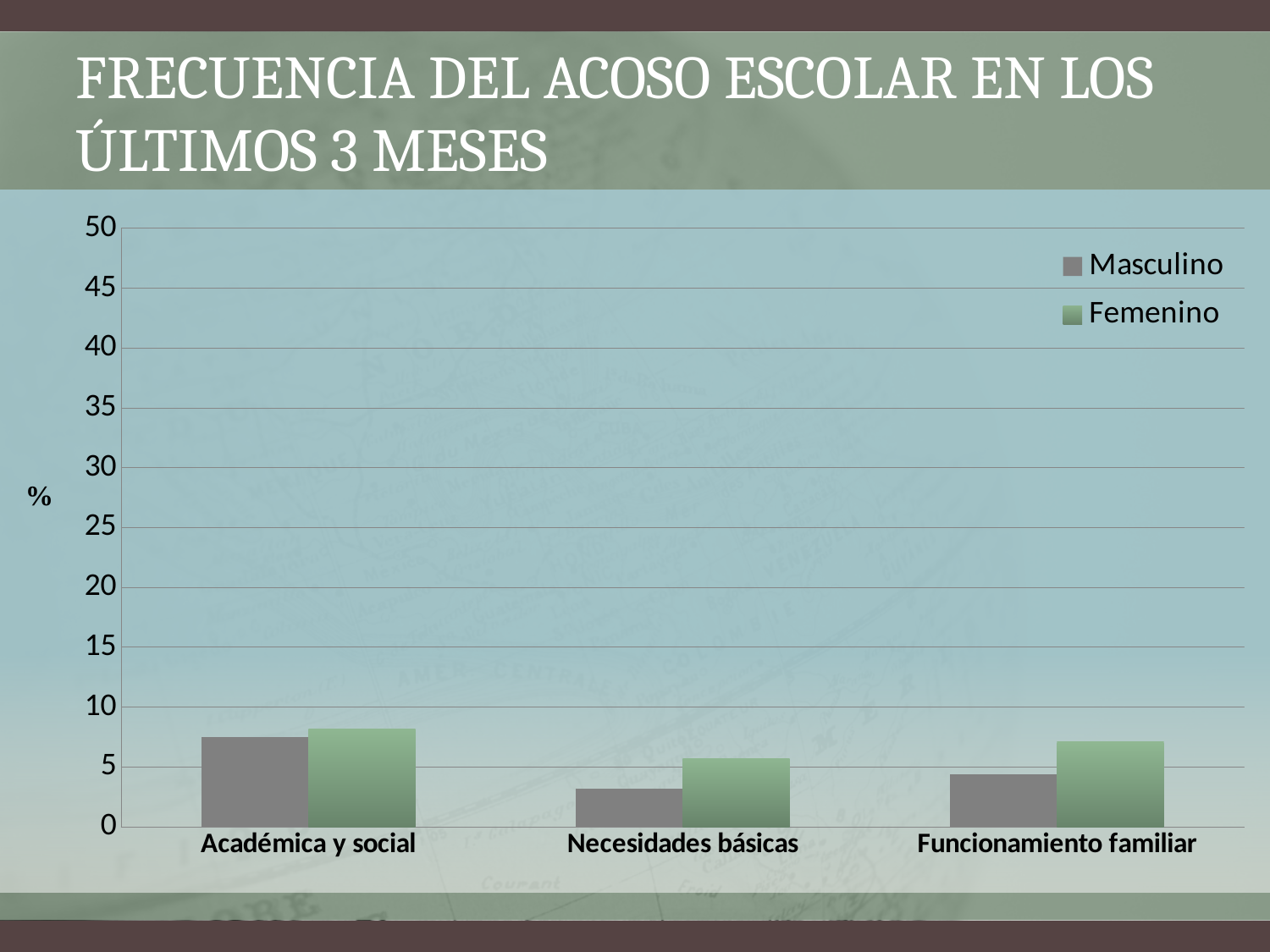
How many categories are shown on the x axis of the chart? 3 Is the Masculino value for Académica y social greater or less than 5? greater What label is shown on the vertical axis of the chart? % Is the Femenino value for Académica y social greater or less than 10? less What kind of chart is shown on the slide? bar chart For Necesidades básicas, which series has the larger value, Masculino or Femenino? Femenino Which category has the lowest Masculino value? Necesidades básicas Is the Femenino value for Funcionamiento familiar greater or less than 5? greater For Funcionamiento familiar, which series has the larger value, Masculino or Femenino? Femenino What are the two series named in the legend? Masculino and Femenino How many series does the chart's legend list? 2